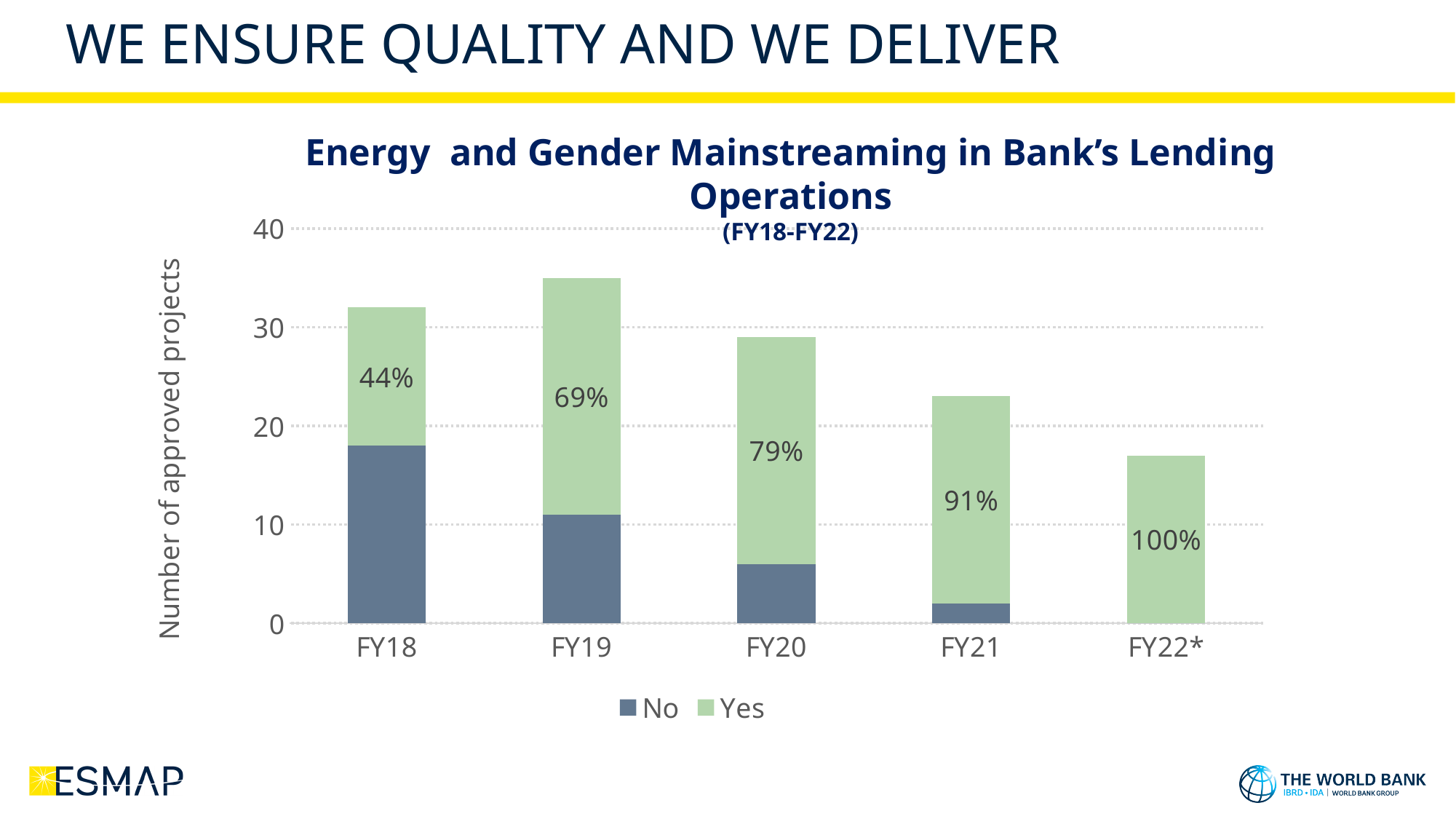
What percentage label is shown for FY22*? 100% What percentage label is shown on the Yes segment for FY21? 91% What percentage label is shown on the Yes segment for FY19? 69% Which has a higher percentage label, FY19 or FY20? FY20 Which fiscal year has the highest percentage label on its Yes segment? FY22* What is the difference between the percentage labels for FY20 and FY18? 35% Which fiscal year has the lowest percentage label on its Yes segment? FY18 How many fiscal years are shown on the x axis? 5 Do the percentage labels rise or fall from FY18 to FY22*? rise Is the total height of the FY19 bar greater or less than 30? greater Is the total height of the FY22* bar greater or less than 20? less How many series does the legend list? 2